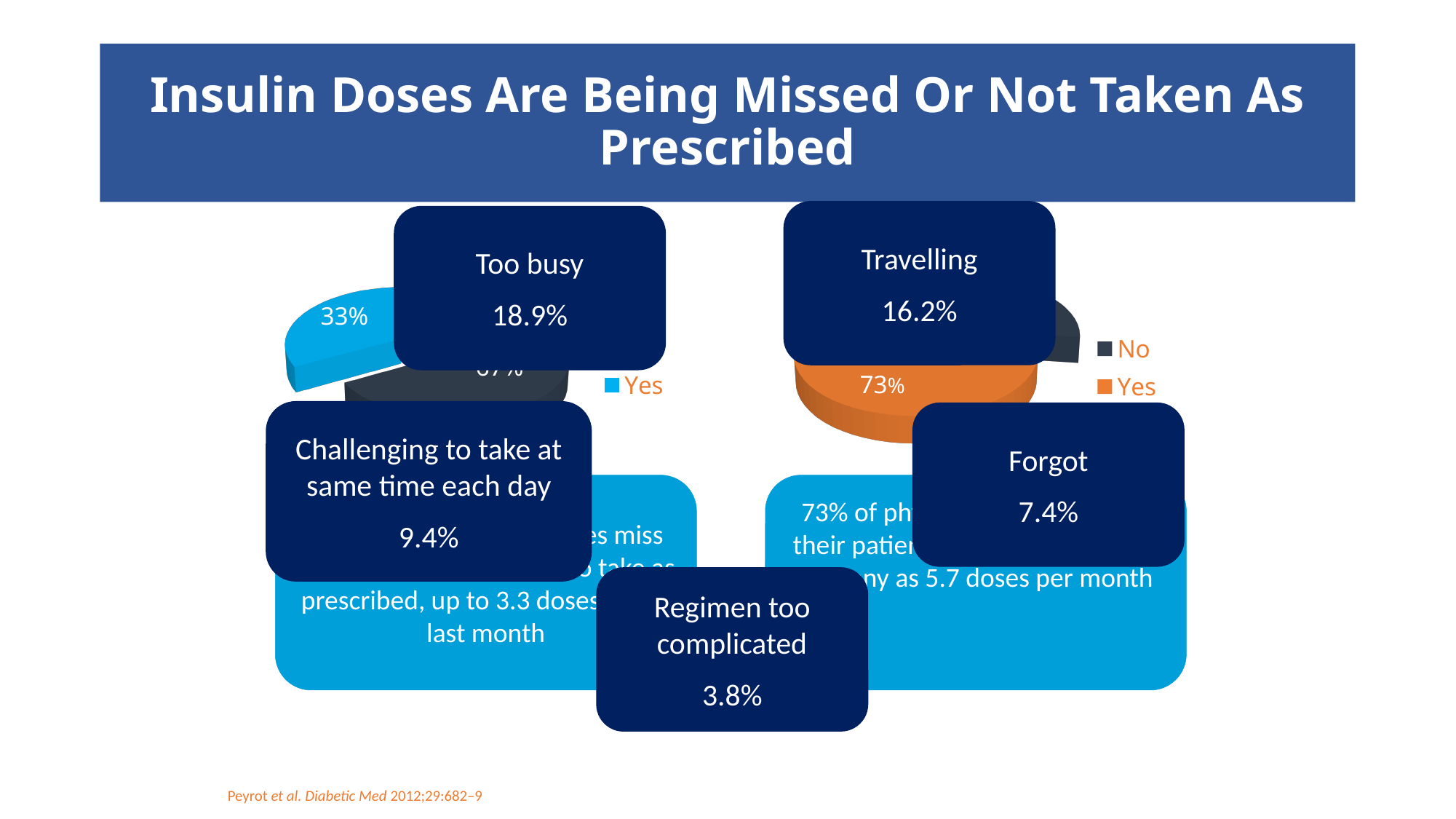
In the right pie chart, which is larger, the No slice or the Yes slice? Yes In the right pie chart, which category has the largest slice? Yes How many pie charts are on the slide? 2 In the right pie chart, what is the value shown for the Yes slice? 73% What colour is the Yes slice in the right pie chart? Orange In the right pie chart, which category has the smallest slice? No How many entries does the legend of the right pie chart list? 2 In the left pie chart, is the Yes slice greater or less than 50%? less In the left pie chart, what is the value shown for the Yes slice? 33% In the right pie chart, is the Yes slice greater or less than 50%? greater What kind of charts are shown on the slide? Pie charts What colour is the Yes slice in the left pie chart? Light blue